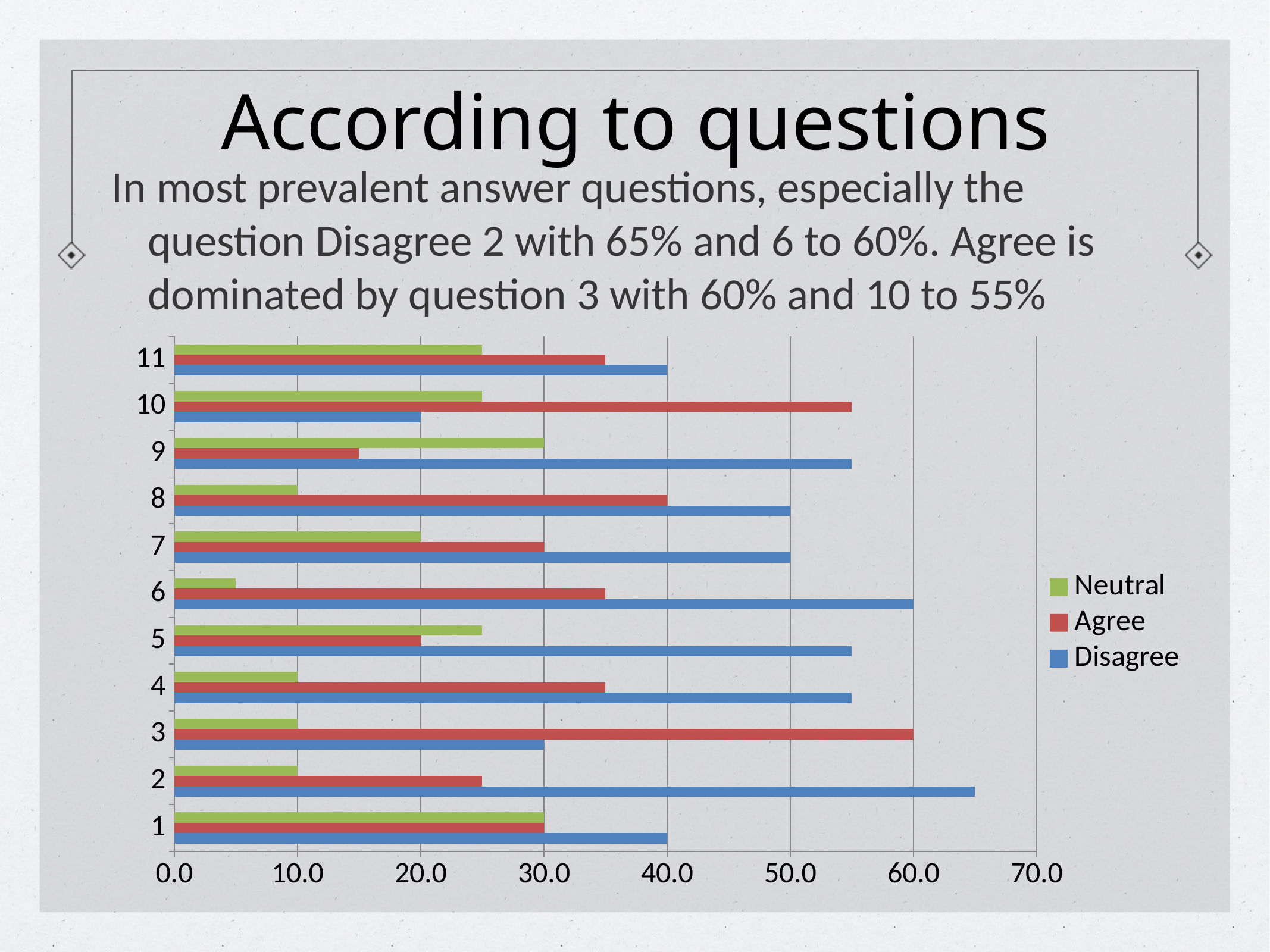
How many series does the legend list? 3 For question 10, which is larger: Agree or Disagree? Agree What is the difference between the Agree and Disagree values for question 3? 30.0 Which question has the highest Agree value? 3 What is the Disagree value for question 1? 40.0 How many questions (categories) are shown on the chart? 11 What is the Neutral value for question 9? 30.0 What kind of chart is shown on the slide? bar chart Is the Disagree value for question 2 greater or less than 60.0? greater What is the Agree value for question 3? 60.0 Which question has the lowest Neutral value? 6 Which question has the highest Disagree value? 2